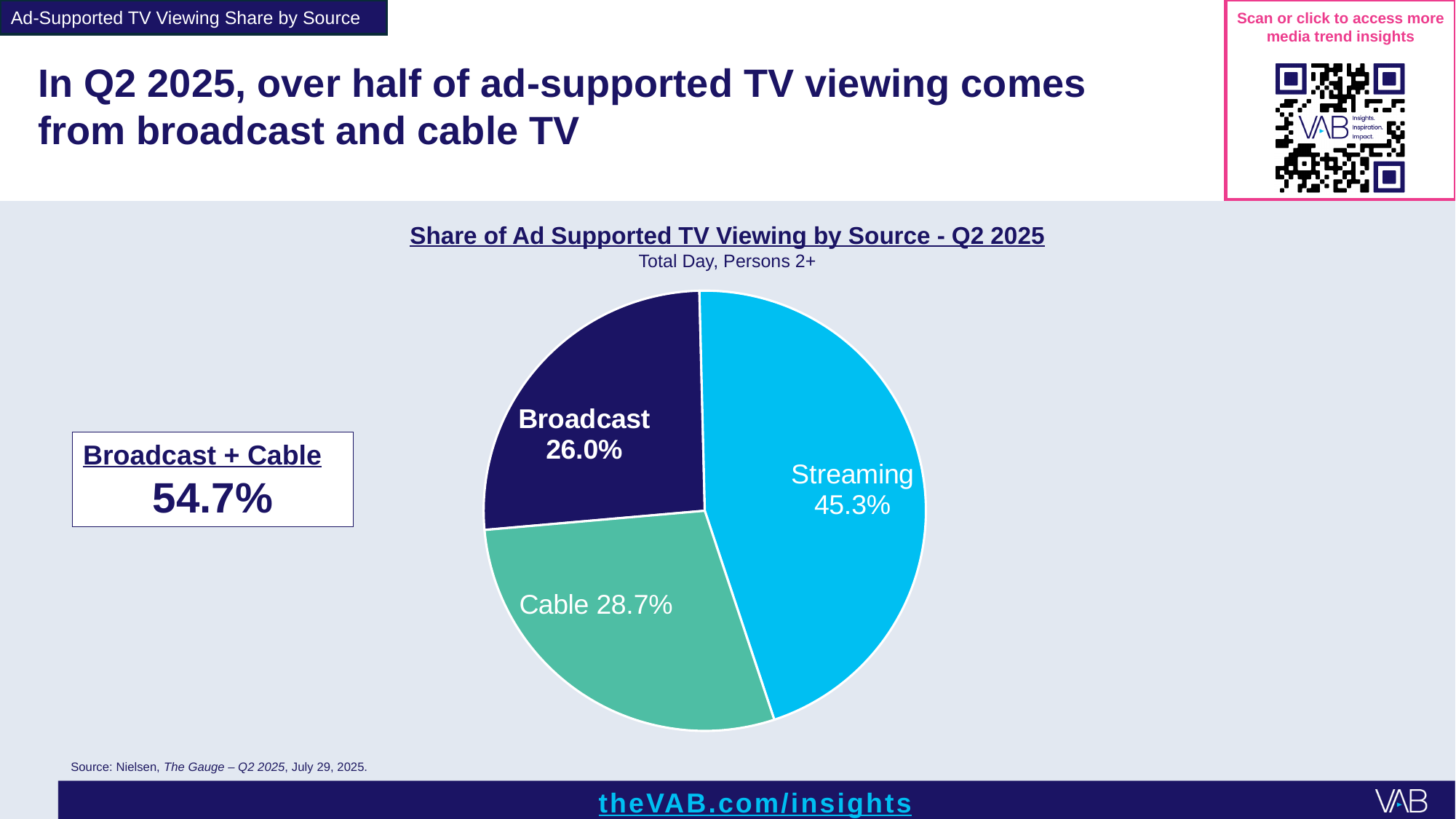
What share of ad-supported TV viewing does Broadcast account for in the pie chart? 26.0% Which has a larger share of ad-supported TV viewing, Cable or Broadcast? Cable What kind of chart is used to show the share of ad-supported TV viewing by source? Pie chart What is the difference in percentage points between the Streaming share and the Cable share? 16.6 What is the title of the chart on the slide? Share of Ad Supported TV Viewing by Source - Q2 2025 What is the difference in percentage points between the Cable share and the Broadcast share? 2.7 Which source has the largest share of ad-supported TV viewing in the pie chart? Streaming What share of ad-supported TV viewing does Cable account for in the pie chart? 28.7% Which source has the smallest share of ad-supported TV viewing in the pie chart? Broadcast How many sources (slices) are shown in the pie chart? 3 What is the combined share of Broadcast and Cable shown on the slide? 54.7% What share of ad-supported TV viewing does Streaming account for in the pie chart? 45.3%